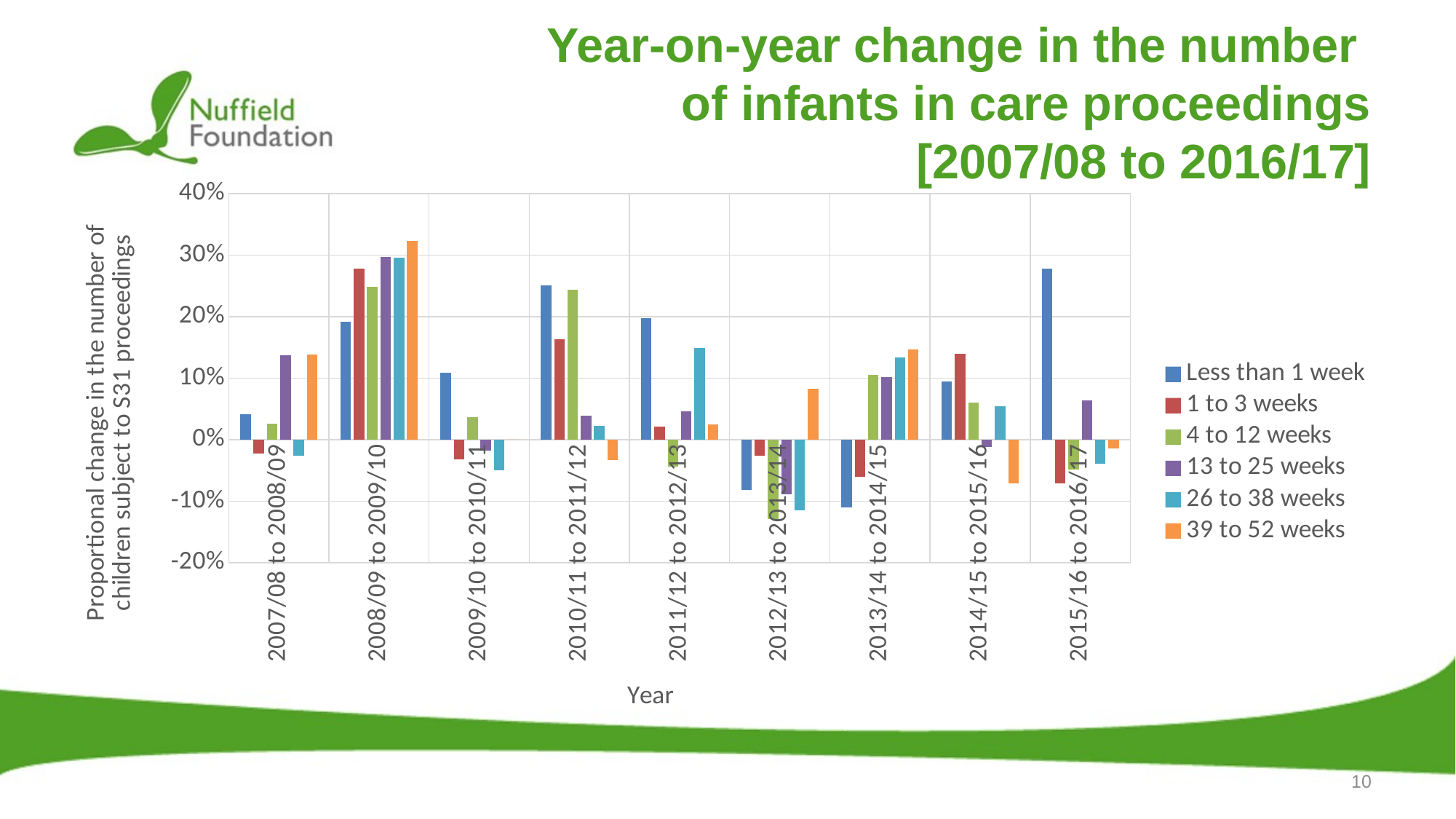
Is the value for '39 to 52 weeks' in 2008/09 to 2009/10 greater or less than 30%? greater What is the title of the x axis? Year Is the value for '26 to 38 weeks' in 2011/12 to 2012/13 greater or less than 10%? greater How many series does the legend list? 6 What kind of chart is shown on the slide? bar chart Is the value for 'Less than 1 week' in 2013/14 to 2014/15 greater or less than -10%? less In 2008/09 to 2009/10, which age group has the highest year-on-year change? 39 to 52 weeks Which series is listed first in the legend? Less than 1 week How many year-to-year periods are shown on the x axis? 9 In 2012/13 to 2013/14, which age group has the lowest year-on-year change? 4 to 12 weeks In 2010/11 to 2011/12, which is larger: the value for 'Less than 1 week' or for '1 to 3 weeks'? Less than 1 week